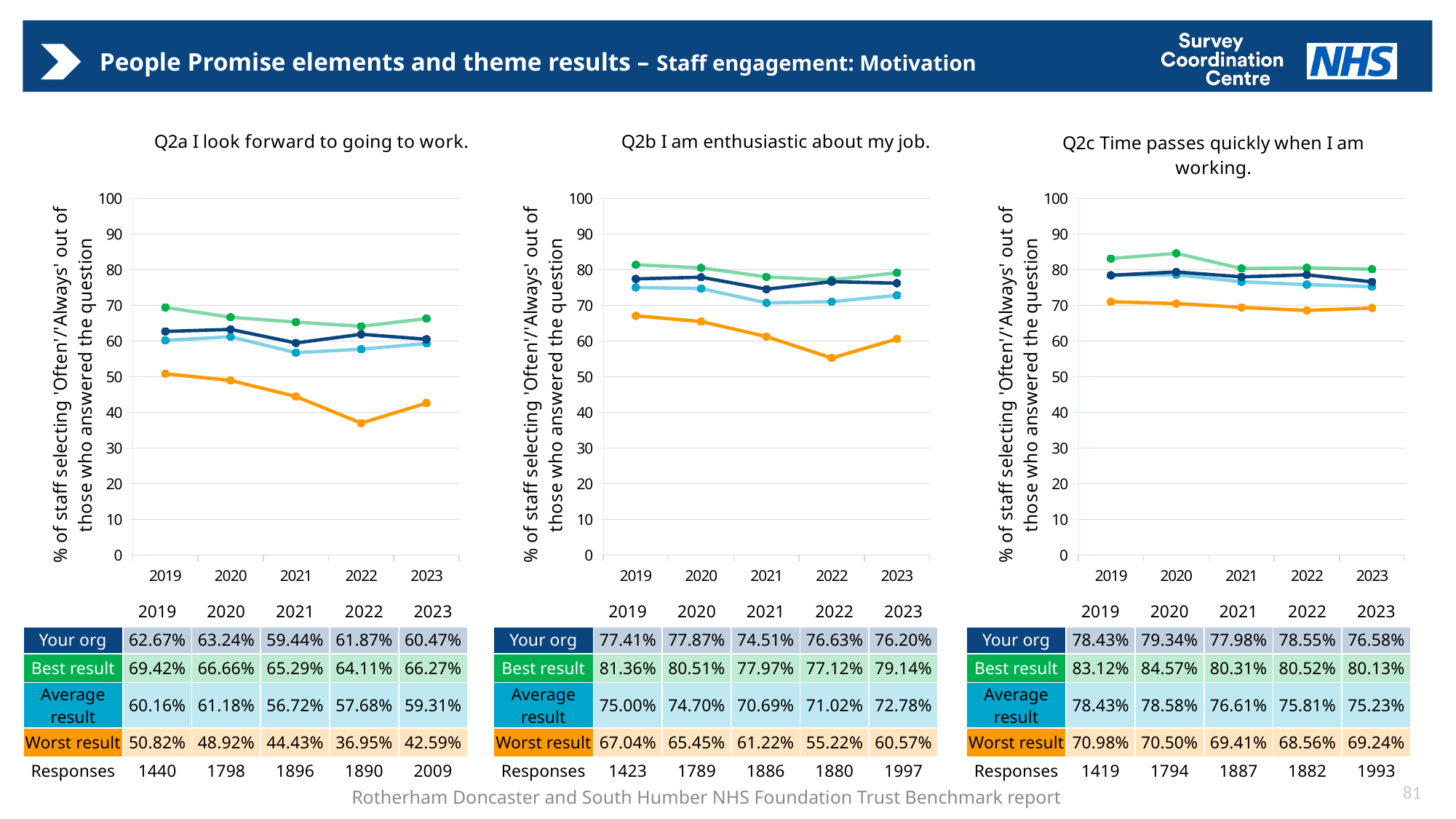
In the chart 'Q2c Time passes quickly when I am working.', what is the 'Best result' value for 2020? 84.57% In the chart 'Q2b I am enthusiastic about my job.', what is the 'Worst result' value for 2022? 55.22% In the chart 'Q2c Time passes quickly when I am working.', in which year is the 'Best result' value highest? 2020 In the chart 'Q2b I am enthusiastic about my job.', what is the difference between the 'Your org' and 'Average result' values for 2023? 3.42 percentage points In the chart 'Q2a I look forward to going to work.', in which year is the 'Worst result' value lowest? 2022 In the chart 'Q2a I look forward to going to work.', which year has the higher 'Your org' value, 2019 or 2020? 2020 In the chart 'Q2c Time passes quickly when I am working.', how many responses were recorded for 2023? 1993 How many years are shown on the x axis of the chart 'Q2a I look forward to going to work.'? 5 In the chart 'Q2a I look forward to going to work.', what is the 'Your org' value for 2023? 60.47% How many data series (lines) are plotted in the chart 'Q2b I am enthusiastic about my job.'? 4 In the chart 'Q2b I am enthusiastic about my job.', is the 'Worst result' value for 2022 greater or less than 60? less What type of chart is used for 'Q2c Time passes quickly when I am working.'? Line chart